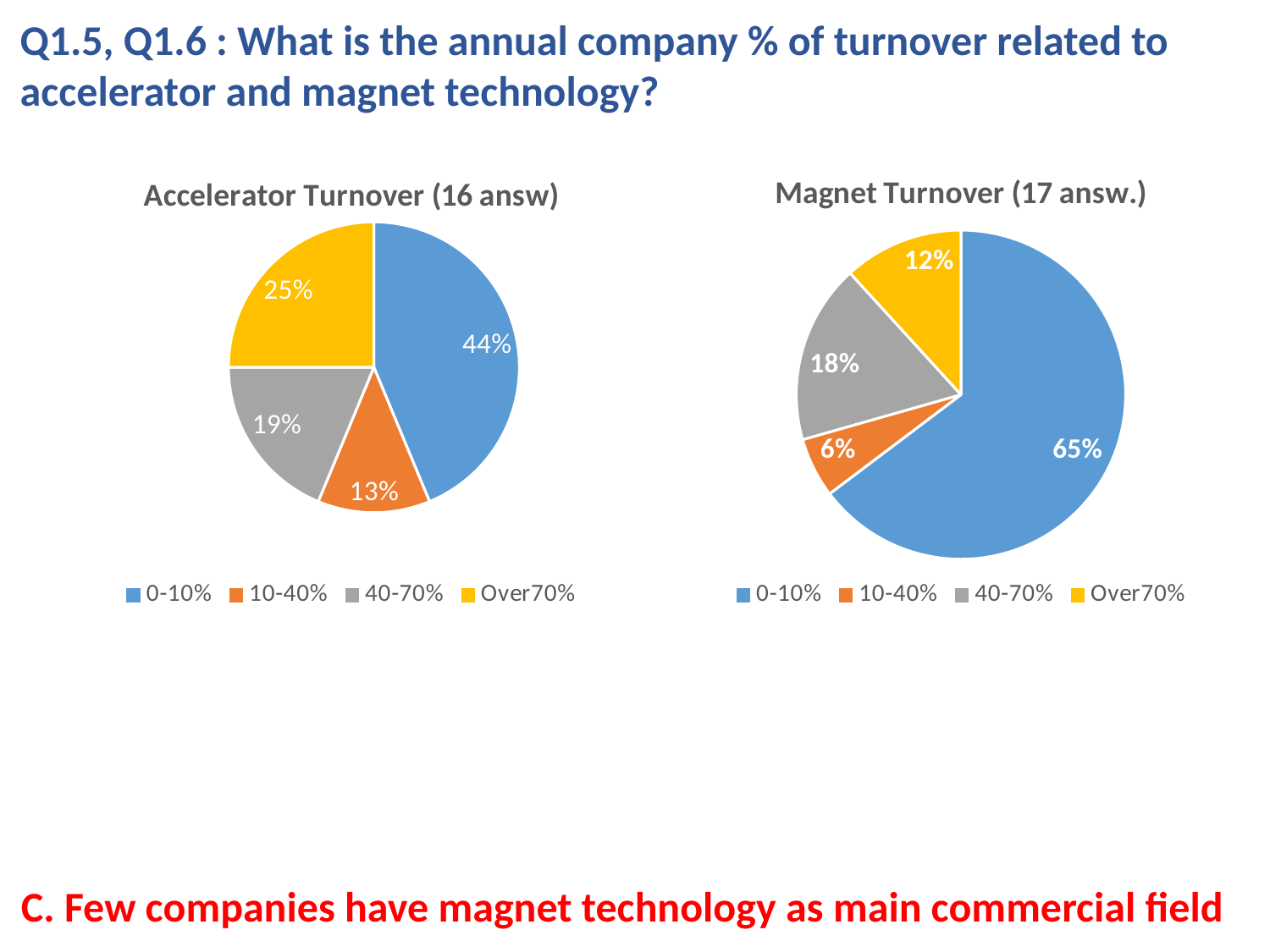
In the Magnet Turnover (17 answ.) chart, what is the difference between the 0-10% share and the Over70% share? 53% Which chart shows a larger share for the 0-10% category, Accelerator Turnover or Magnet Turnover? Magnet Turnover In the Magnet Turnover (17 answ.) chart, what share is labelled for the 10-40% category? 6% In the Accelerator Turnover (16 answ) chart, what share is labelled for the 0-10% category? 44% In the Magnet Turnover (17 answ.) chart, what share is labelled for the 40-70% category? 18% In the Accelerator Turnover (16 answ) chart, what is the difference between the Over70% share and the 40-70% share? 6% How many categories does the Magnet Turnover (17 answ.) chart show? 4 In the Accelerator Turnover (16 answ) chart, which category has the smallest slice? 10-40% In the Magnet Turnover (17 answ.) chart, which category has the smallest slice? 10-40% In the Accelerator Turnover (16 answ) chart, which category has the largest slice? 0-10% In the Accelerator Turnover (16 answ) chart, what colour is the Over70% slice? Yellow What kind of chart is the Accelerator Turnover (16 answ) chart? Pie chart